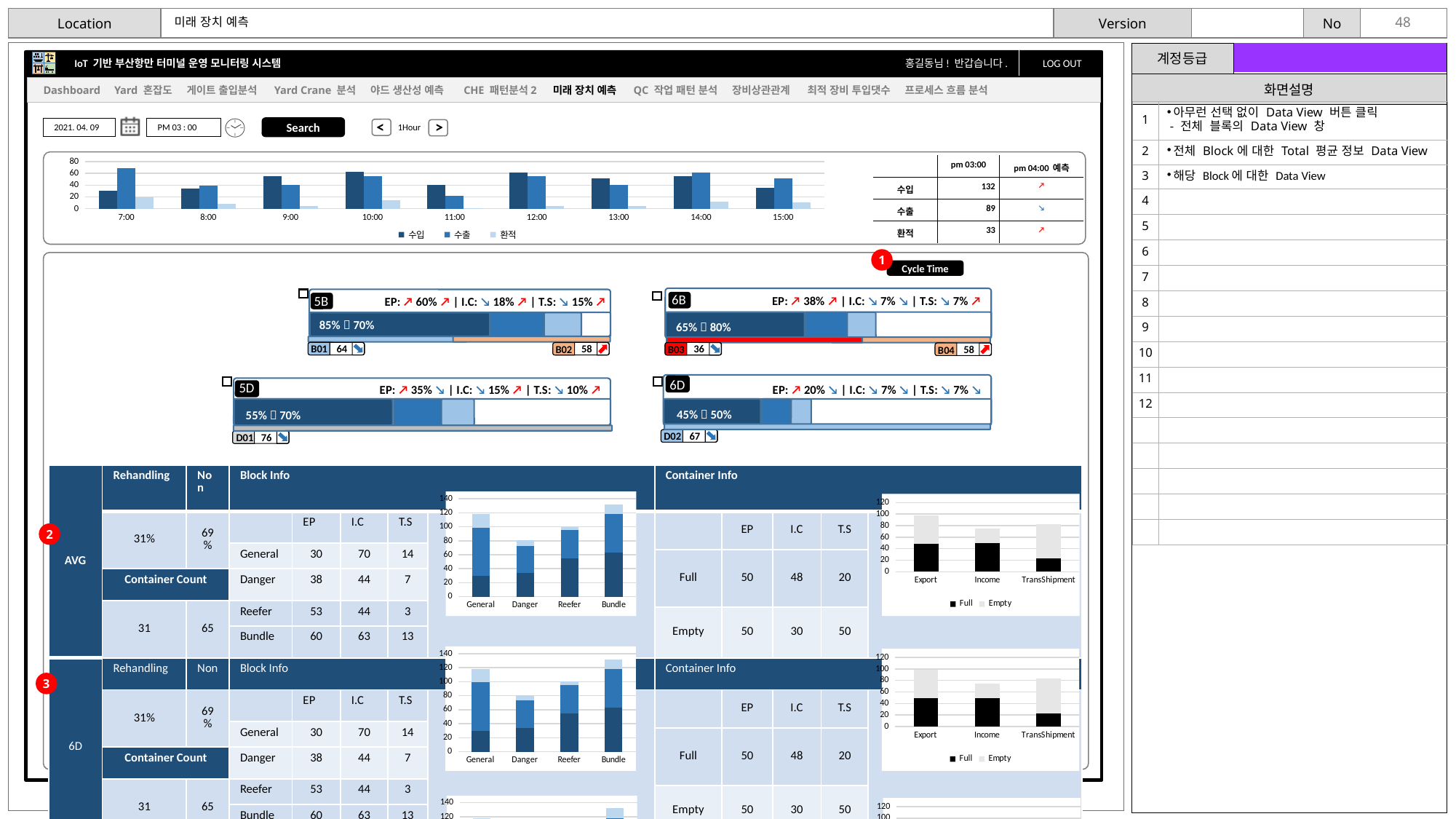
In the Block Info chart of the AVG section, which category has the shortest stacked bar? Danger In the hourly bar chart at the top of the slide, how many time categories are shown on the x axis? 9 In the hourly bar chart at the top of the slide, at which hour is the 수출 value lowest? 11:00 In the Block Info chart of the AVG section, how many categories are on the x axis? 4 In the hourly bar chart at the top of the slide, is the 환적 value at 11:00 greater or less than 20? less In the Container Info chart of the AVG section, how many series does the legend list? 2 In the hourly bar chart at the top of the slide, is the 수출 value at 7:00 greater or less than 60? greater In the Container Info chart of the AVG section, is the Full value for TransShipment greater or less than 40? less What kind of chart is the Block Info chart in the AVG section? stacked bar chart In the hourly bar chart at the top of the slide, how many series does the legend list? 3 In the Block Info chart of the AVG section, which category has the tallest stacked bar? Bundle